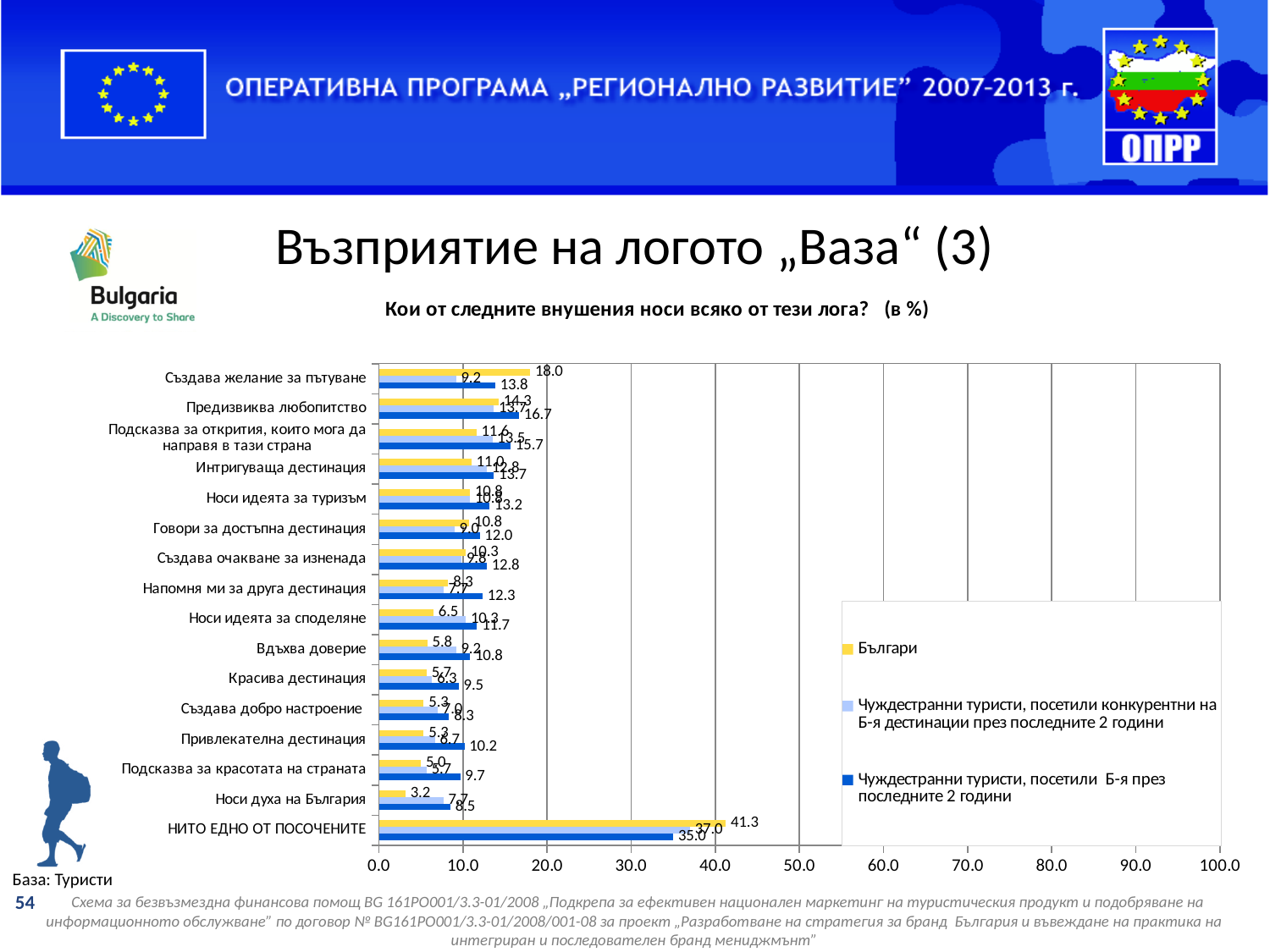
What is the difference between the Българи value and the "Чуждестранни туристи, посетили Б-я през последните 2 години" value in the category "НИТО ЕДНО ОТ ПОСОЧЕНИТЕ"? 6.3 What type of chart is shown on the slide? bar chart Which category has the highest value for Българи? НИТО ЕДНО ОТ ПОСОЧЕНИТЕ What is the value for "Чуждестранни туристи, посетили Б-я през последните 2 години" in the category "НИТО ЕДНО ОТ ПОСОЧЕНИТЕ"? 35.0 What is the value for Българи in the category "НИТО ЕДНО ОТ ПОСОЧЕНИТЕ"? 41.3 Is the value for Българи in the category "НИТО ЕДНО ОТ ПОСОЧЕНИТЕ" greater or less than 40.0? greater What is the value for Българи in the category "Носи духа на България"? 3.2 How many categories are shown on the vertical axis of the chart? 16 What is the value for "Чуждестранни туристи, посетили Б-я през последните 2 години" in the category "Предизвиква любопитство"? 16.7 What is the value for Българи in the category "Създава желание за пътуване"? 18.0 How many series does the legend list? 3 In the category "Създава желание за пътуване", which is larger: the value for Българи or the value for "Чуждестранни туристи, посетили Б-я през последните 2 години"? Българи